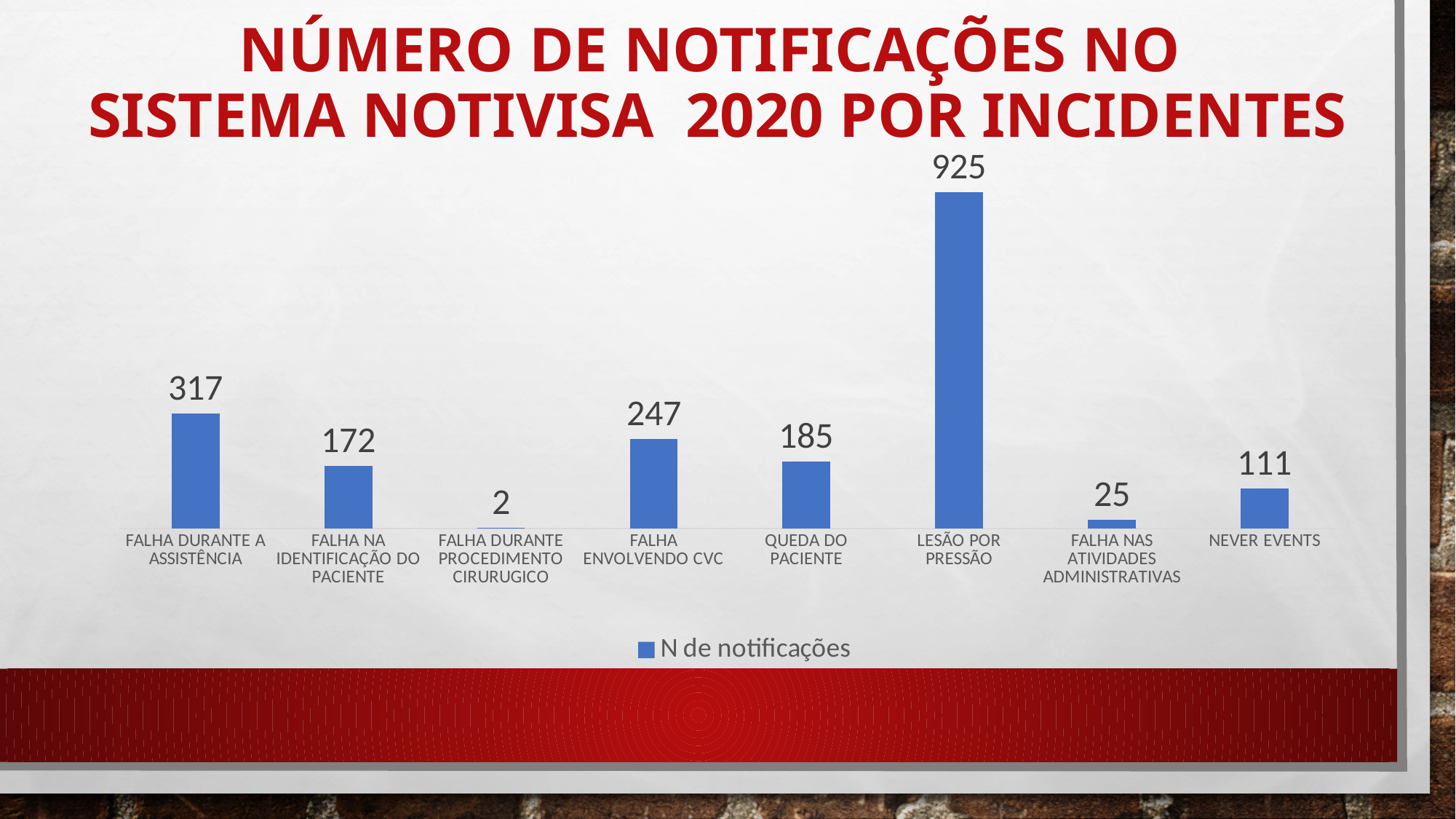
Which incident category has the lowest number of notifications? FALHA DURANTE PROCEDIMENTO CIRURUGICO What is the number of notifications for LESÃO POR PRESSÃO? 925 Which has more notifications, FALHA NA IDENTIFICAÇÃO DO PACIENTE or QUEDA DO PACIENTE? QUEDA DO PACIENTE What is the number of notifications for FALHA DURANTE A ASSISTÊNCIA? 317 What is the difference between the notifications for FALHA ENVOLVENDO CVC and QUEDA DO PACIENTE? 62 What is the difference between the notifications for LESÃO POR PRESSÃO and FALHA DURANTE A ASSISTÊNCIA? 608 How many series does the legend list? 1 Which incident category has the highest number of notifications? LESÃO POR PRESSÃO What is the legend entry for the series shown in the chart? N de notificações How many incident categories are shown in the chart? 8 What kind of chart is shown on the slide? Bar chart What is the number of notifications for NEVER EVENTS? 111